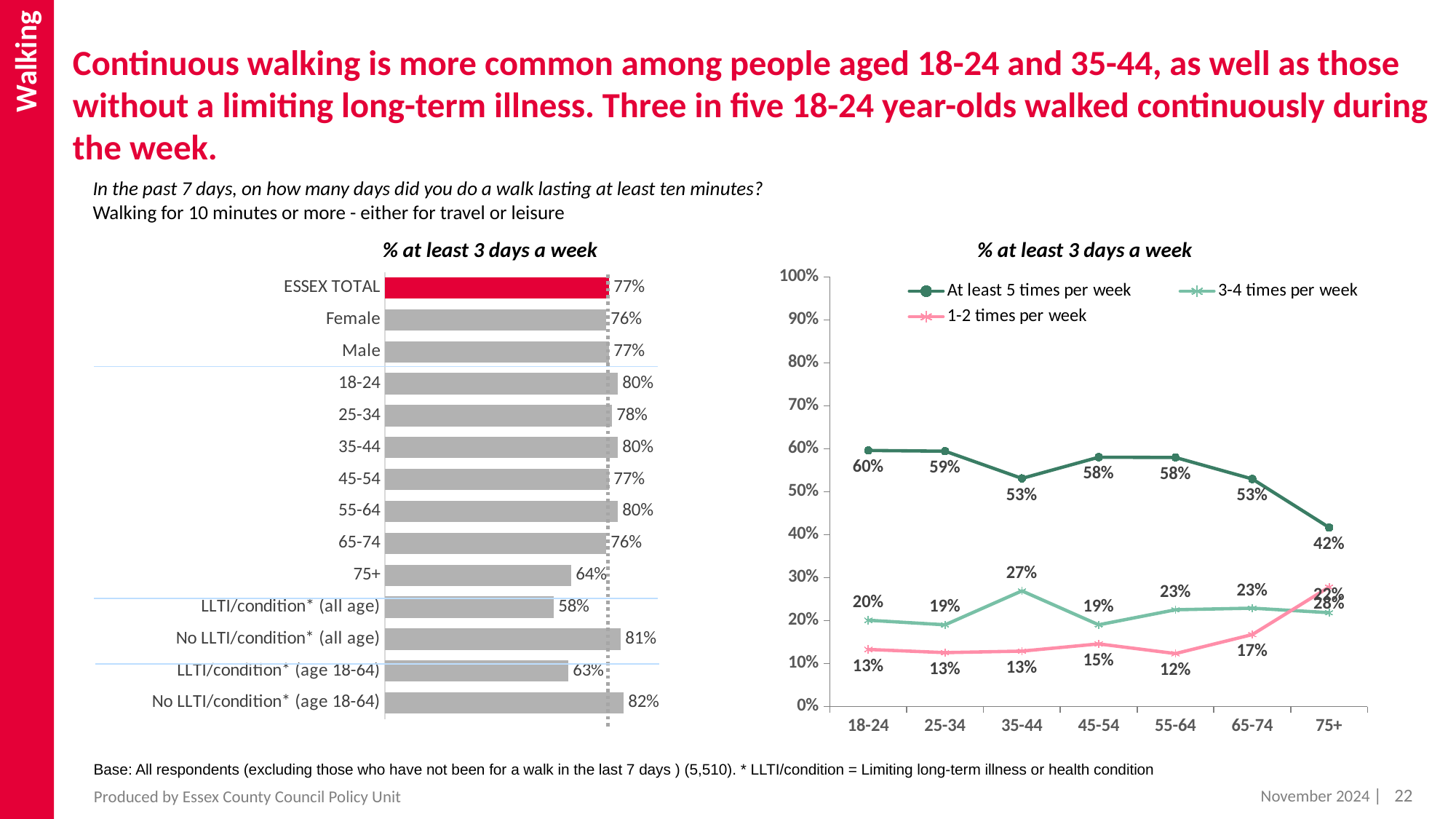
What type of chart is the chart on the left? Bar chart On the left bar chart, what is the difference between No LLTI/condition* (all age) and LLTI/condition* (all age)? 23% On the left bar chart, which is larger, the value for 18-24 or the value for 75+? 18-24 On the right line chart, how many series does the legend list? 3 On the right line chart, how many age groups are shown on the x axis? 7 On the right line chart, what is the value for 3-4 times per week at 35-44? 27% On the left bar chart, which category has the lowest value? LLTI/condition* (all age) On the right line chart, what is the value for At least 5 times per week at 18-24? 60% On the left bar chart, what is the value for ESSEX TOTAL? 77% On the right line chart, what is the difference between At least 5 times per week at 18-24 and at 75+? 18% On the left bar chart, which category has the highest value? No LLTI/condition* (age 18-64) On the left bar chart, what is the value for 75+? 64%